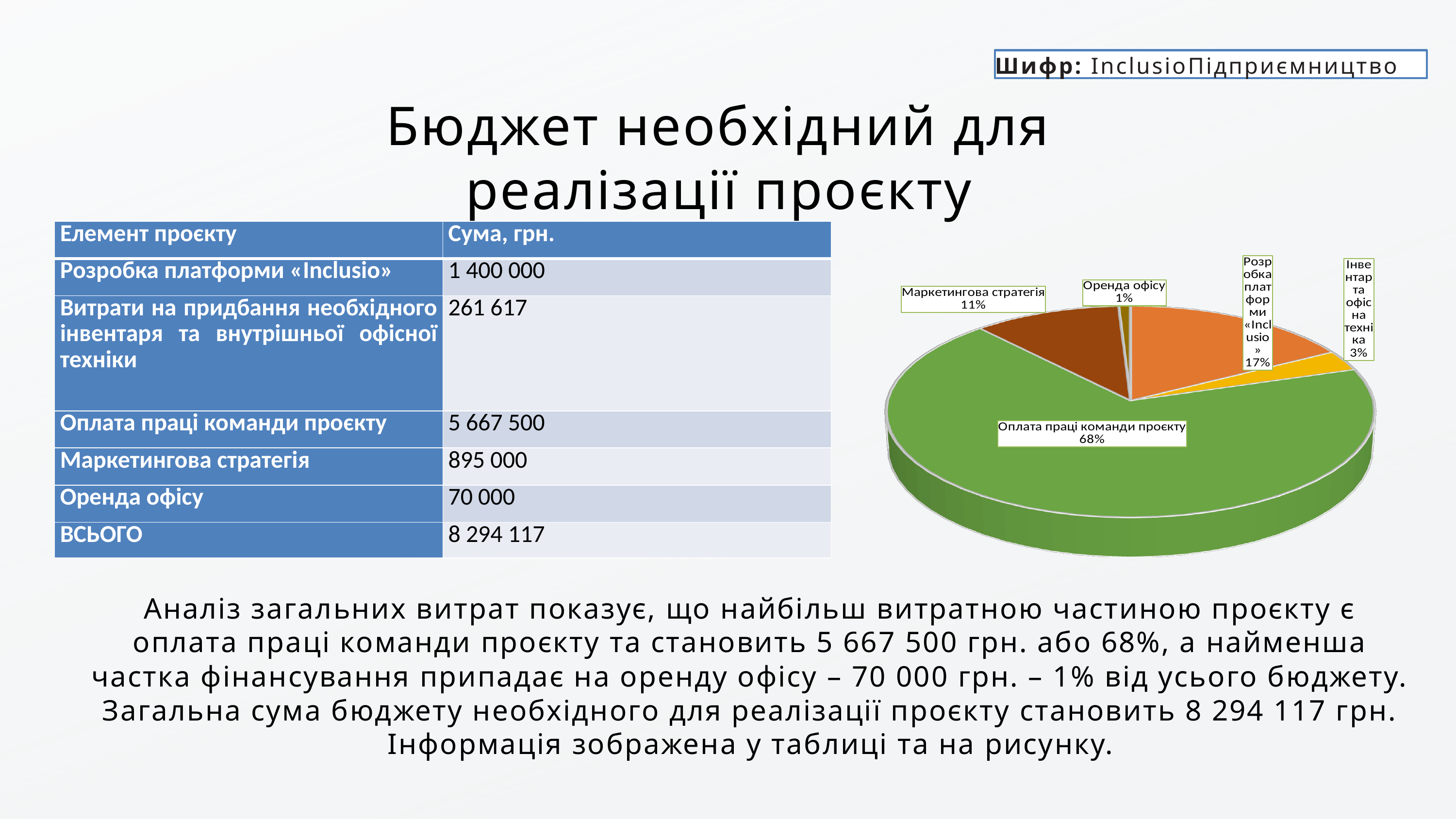
What is the difference in percentage points between the "Оплата праці команди проєкту" slice and the "Розробка платформи «Inclusio»" slice? 51 What colour is the "Оплата праці команди проєкту" slice in the pie chart? green Which slice of the pie chart is the smallest? Оренда офісу What share of the pie does "Оплата праці команди проєкту" have? 68% What kind of chart is shown on the slide? pie chart What share of the pie does "Оренда офісу" have? 1% What share of the pie does "Маркетингова стратегія" have? 11% Which slice of the pie chart is the largest? Оплата праці команди проєкту Which slice is larger: "Маркетингова стратегія" or "Розробка платформи «Inclusio»"? Розробка платформи «Inclusio» How many slices does the pie chart have? 5